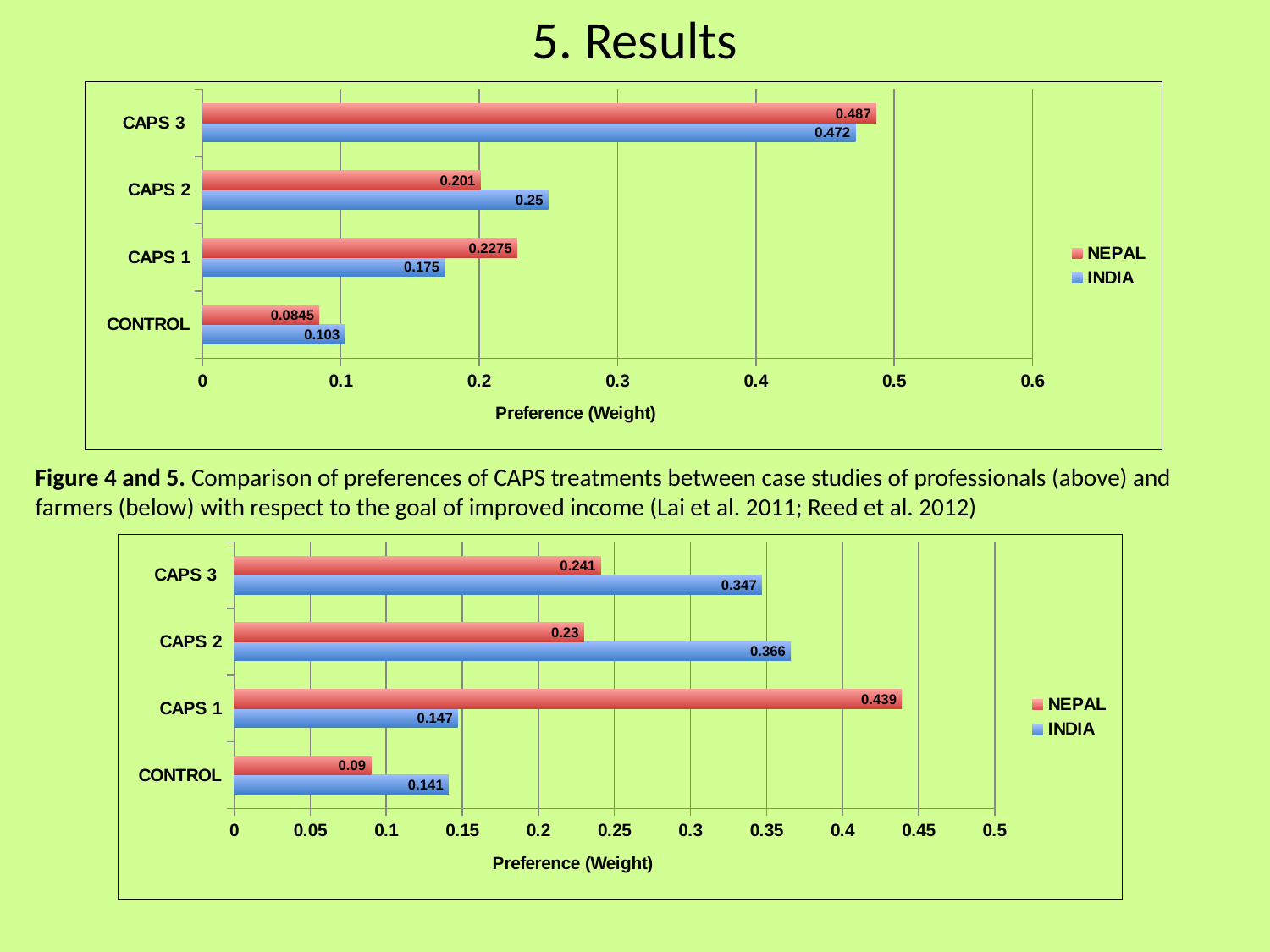
How many series does the legend of the bottom chart list? 2 What type of chart is the top chart? Bar chart In the top chart, what is the INDIA value for CAPS 2? 0.25 In the top chart, which category has the highest INDIA value? CAPS 3 In the top chart, what is the NEPAL value for CAPS 3? 0.487 In the bottom chart, is the INDIA value for CAPS 3 greater or less than 0.3? greater In the bottom chart, what is the NEPAL value for CAPS 1? 0.439 In the top chart, which is larger for CAPS 1: the NEPAL value or the INDIA value? NEPAL In the bottom chart, what is the difference between the INDIA and NEPAL values for CAPS 2? 0.136 In the bottom chart, which category has the lowest NEPAL value? CONTROL In the bottom chart, what is the INDIA value for CONTROL? 0.141 How many categories are shown in the top chart? 4